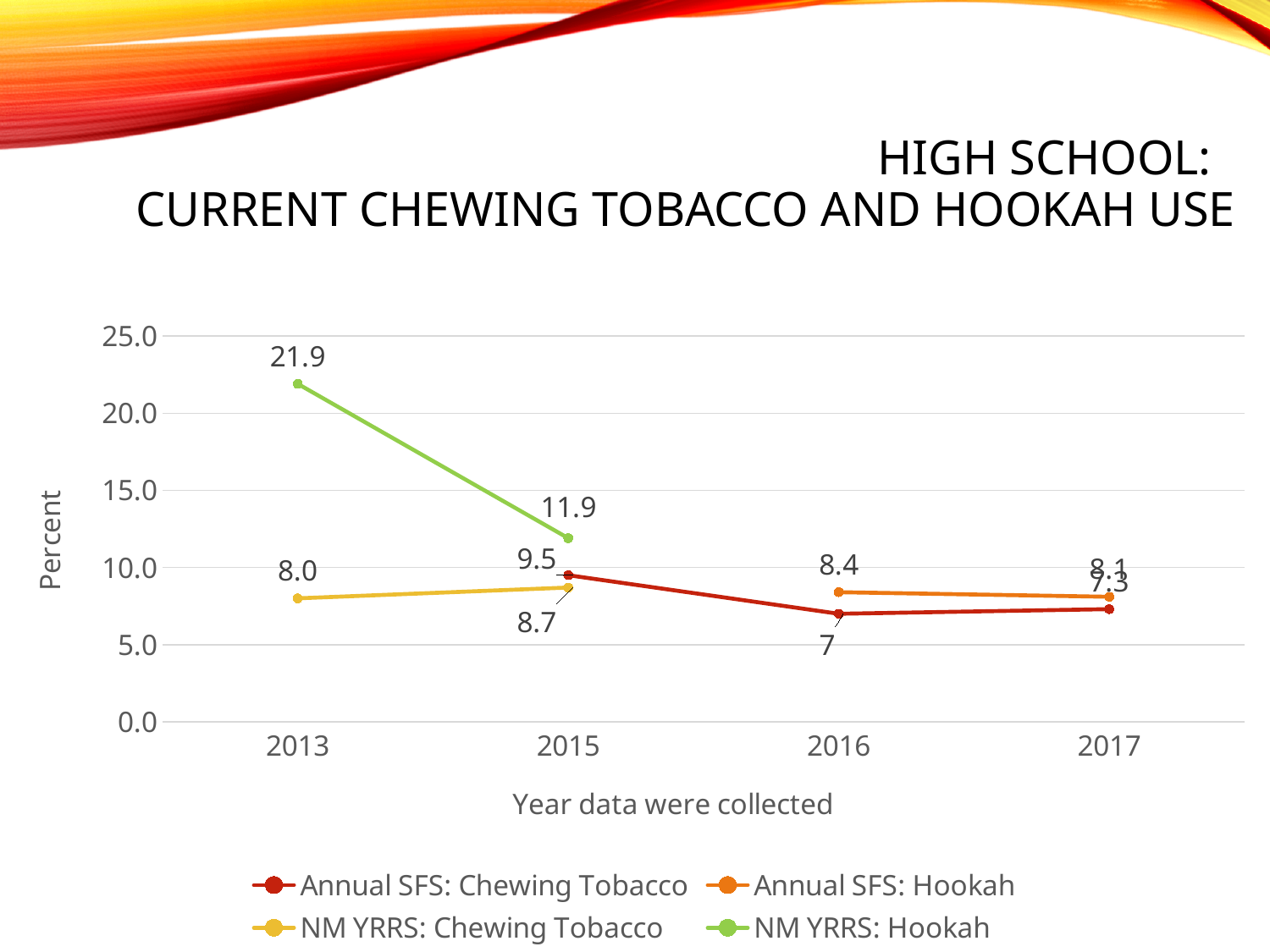
Does the NM YRRS: Hookah line rise or fall from 2013 to 2015? fall What type of chart is shown on the slide? line chart What is the value for NM YRRS: Hookah in 2013? 21.9 Which is larger in 2016, Annual SFS: Hookah or Annual SFS: Chewing Tobacco? Annual SFS: Hookah What is the value for NM YRRS: Chewing Tobacco in 2013? 8.0 How many series does the legend list? 4 Which series has the highest plotted value on the chart? NM YRRS: Hookah What is the value for Annual SFS: Chewing Tobacco in 2016? 7 What is the value for NM YRRS: Hookah in 2015? 11.9 By how much did NM YRRS: Hookah fall from 2013 to 2015? 10.0 How many years are shown on the x axis? 4 What is the value for Annual SFS: Hookah in 2016? 8.4